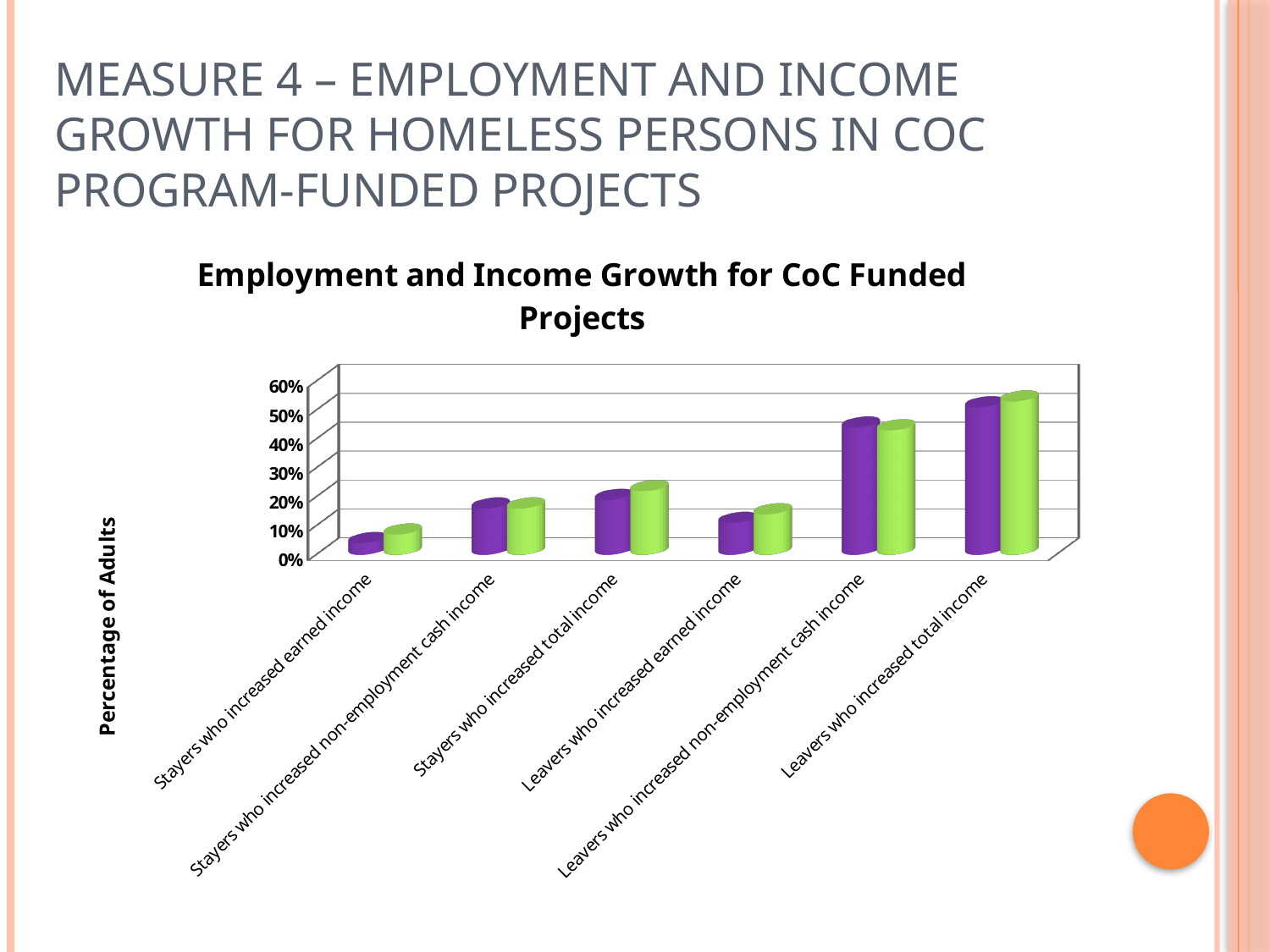
Which is larger: the green bar for 'Leavers who increased non-employment cash income' or the green bar for 'Leavers who increased earned income'? Leavers who increased non-employment cash income What is the label on the vertical axis of the chart? Percentage of Adults Is the green bar for 'Leavers who increased non-employment cash income' greater or less than 30%? greater Which is larger: the purple bar for 'Leavers who increased total income' or the purple bar for 'Stayers who increased total income'? Leavers who increased total income Which category has the lowest bars in the chart? Stayers who increased earned income What is the title of the chart? Employment and Income Growth for CoC Funded Projects Which category has the highest bars in the chart? Leavers who increased total income Is the purple bar for 'Stayers who increased earned income' greater or less than 10%? less How many categories are shown on the x axis of the chart? 6 Is the purple bar for 'Stayers who increased total income' greater or less than 30%? less What kind of chart is shown on the slide? Bar chart